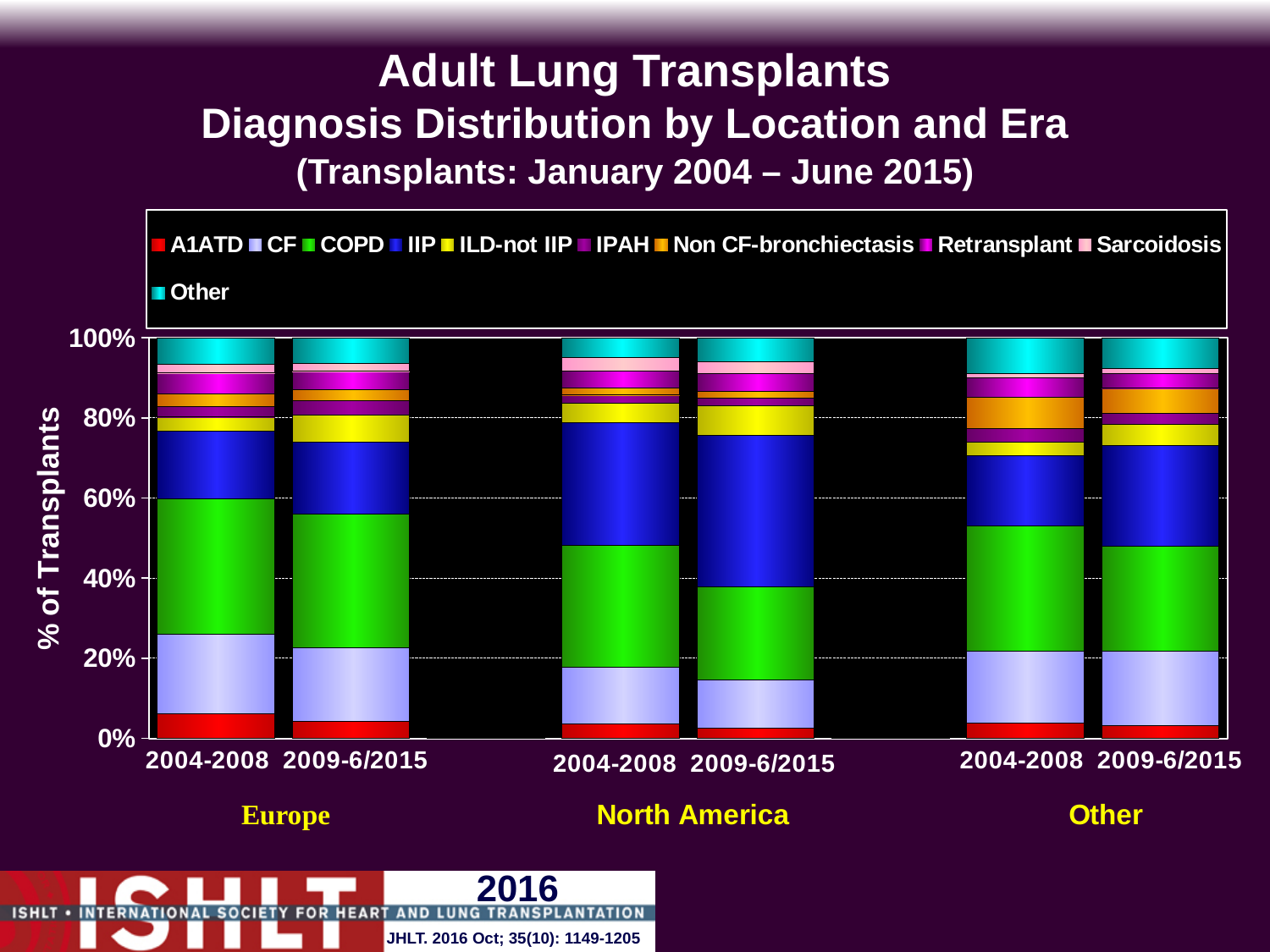
How many stacked bars are plotted in the chart? 6 How many locations are shown along the x axis? 3 Is the IIP share for North America 2009-6/2015 greater or less than 20%? greater What is the label of the y axis? % of Transplants What kind of chart is shown on the slide? Stacked bar chart Is the CF share for North America 2009-6/2015 greater or less than 20%? less How many diagnosis series does the legend list? 10 What does each stacked bar total? 100% Which bar has the larger Non CF-bronchiectasis share: Other 2004-2008 or Europe 2004-2008? Other 2004-2008 Which bar has the larger IIP share: North America 2009-6/2015 or Europe 2009-6/2015? North America 2009-6/2015 For North America, does the IIP share rise or fall from 2004-2008 to 2009-6/2015? rise What colour represents COPD in the legend? Green